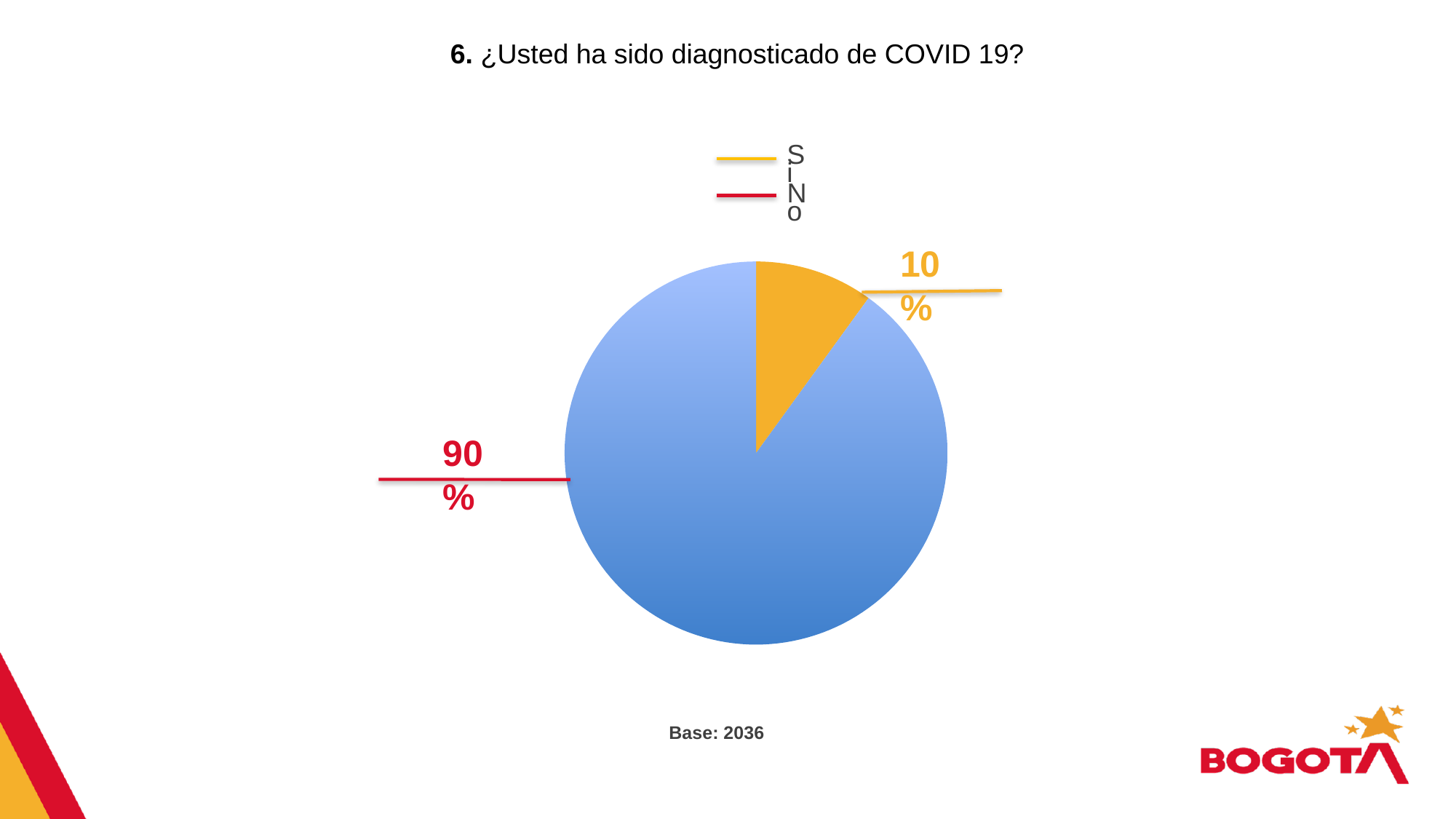
Which is larger, the share for "Si" or the share for "No"? No Which response has the largest share of the pie? No What is the base (number of respondents) shown below the chart? 2036 What kind of chart is shown on the slide? Pie chart What share of the pie does the "Si" slice represent? 10% What percentage of respondents answered "Si" to having been diagnosed with COVID 19? 10% How many entries does the legend list? 2 How many slices does the pie chart have? 2 What percentage of respondents answered "No"? 90% Which response has the smallest share of the pie? Si What is the difference in percentage points between the "No" and "Si" responses? 80 What colour is the larger slice of the pie chart? Blue